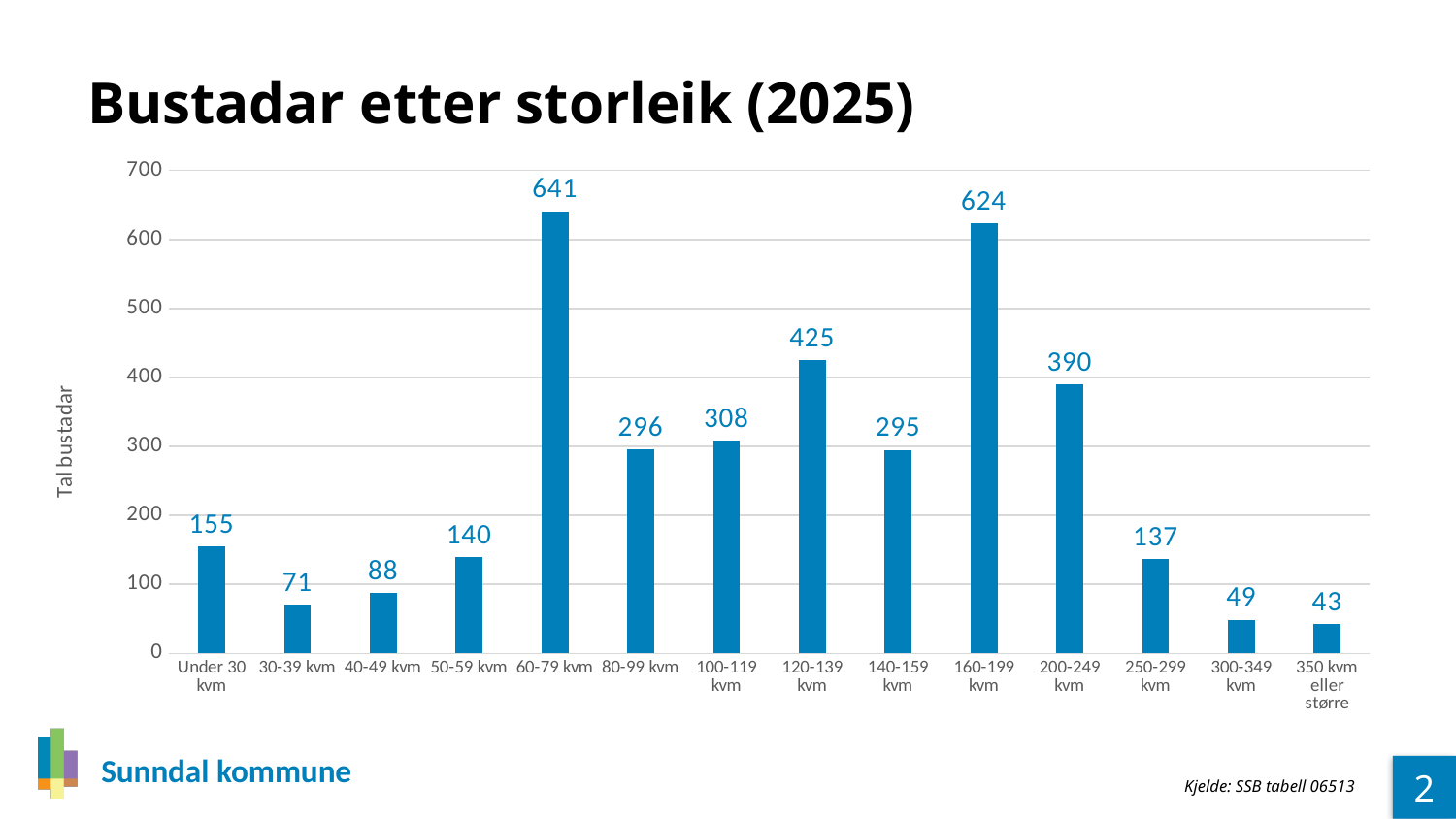
What kind of chart is shown on the slide? bar chart What is the title of the chart? Bustadar etter storleik (2025) How many categories are shown on the x axis? 14 What is the label on the y axis? Tal bustadar What is the difference between the values for 60-79 kvm and 160-199 kvm? 17 What is the value for 200-249 kvm? 390 What is the value for 350 kvm eller større? 43 Which category has the lowest value? 350 kvm eller større Which is larger, the value for 120-139 kvm or the value for 200-249 kvm? 120-139 kvm Is the value for 80-99 kvm greater or less than 200? greater What is the value for 60-79 kvm? 641 Which category has the highest value? 60-79 kvm